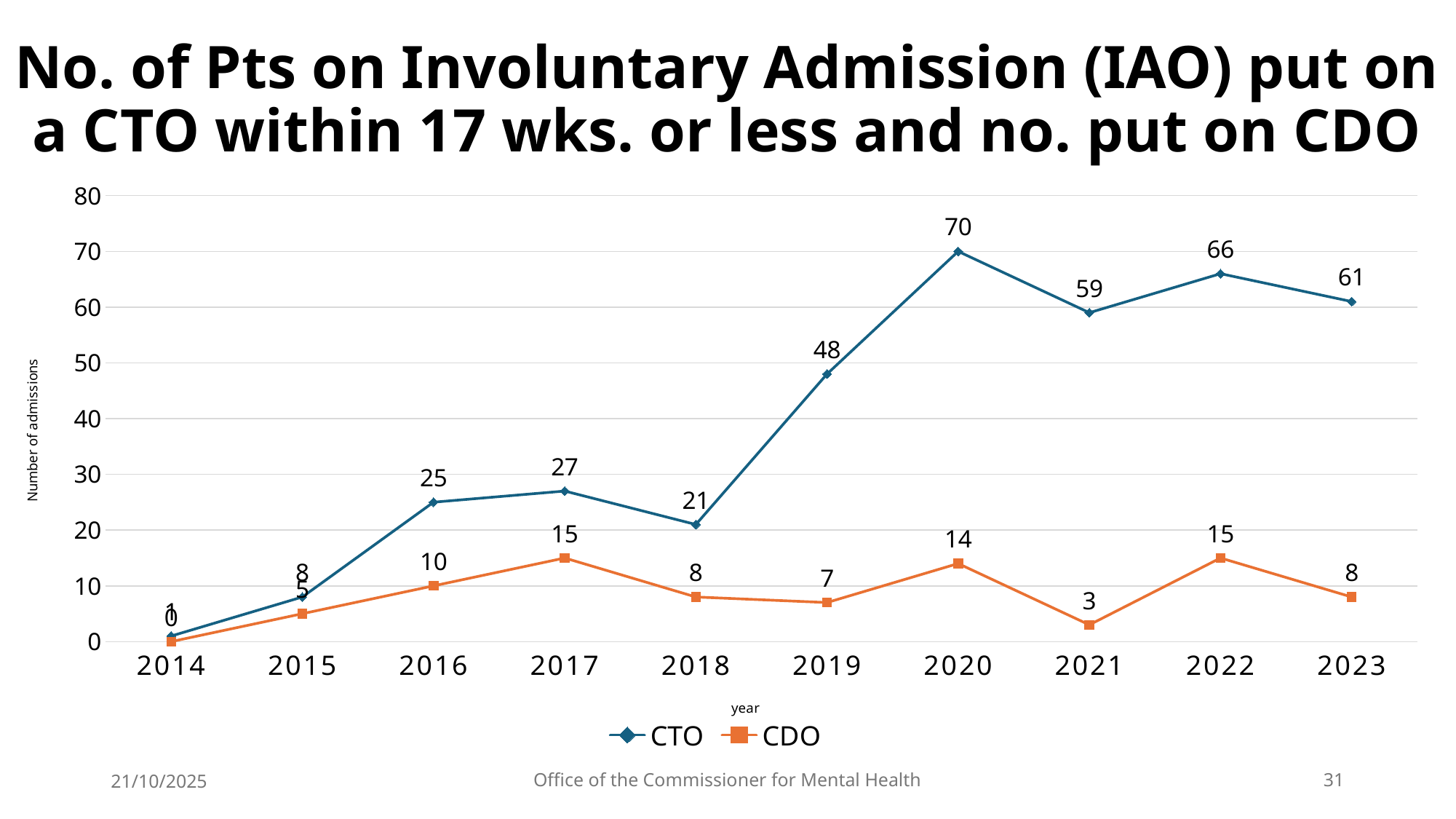
What type of chart is shown on the slide? line chart What is the label of the y axis? Number of admissions How many series does the legend list? 2 Which is larger, the CTO value in 2021 or the CTO value in 2023? 2023 What is the CTO value for 2020? 70 What is the CTO value for 2019? 48 What is the CDO value for 2017? 15 How many years are shown on the x axis? 10 Does the CTO value rise or fall from 2018 to 2020? rise In which year is the CDO value lowest? 2014 What is the difference between the CTO and CDO values in 2022? 51 In which year is the CTO value highest? 2020